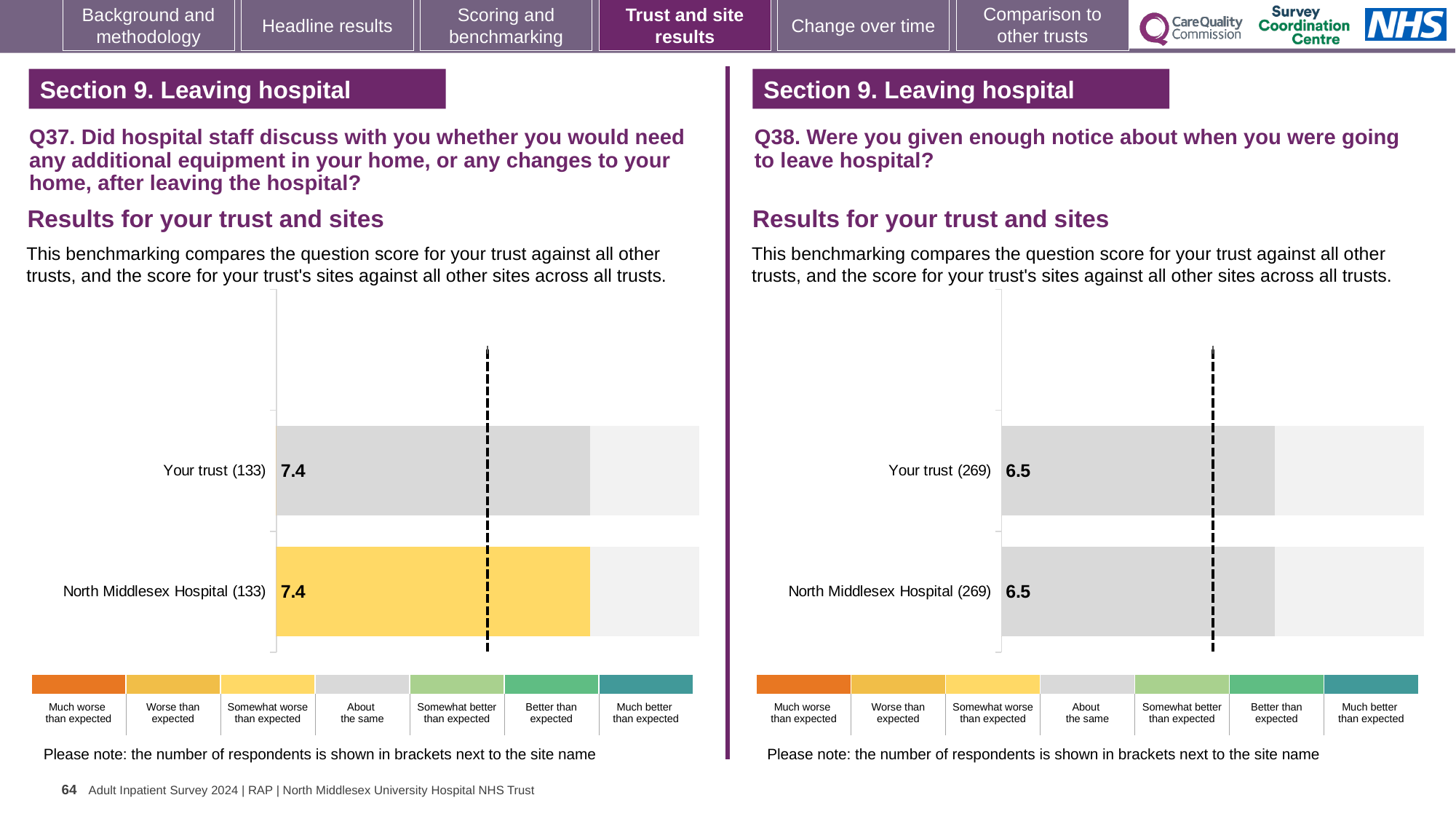
In the Q38 chart on the right, what is the score for Your trust? 6.5 How many bars are plotted in the Q37 chart on the left? 2 How many bars are plotted in the Q38 chart on the right? 2 In the Q37 chart on the left, how many respondents are shown in brackets next to North Middlesex Hospital? 133 In the Q37 chart on the left, what is the score for North Middlesex Hospital? 7.4 In the Q38 chart on the right, what is the difference between the score for Your trust and the score for North Middlesex Hospital? 0.0 In the Q38 chart on the right, how many respondents are shown in brackets next to Your trust? 269 In the Q37 chart on the left, what is the score for Your trust? 7.4 In the Q37 chart on the left, which benchmark category does the colour of the North Middlesex Hospital bar correspond to? Somewhat worse than expected In the Q38 chart on the right, what is the score for North Middlesex Hospital? 6.5 What kind of chart is used for the Q37 results on the left? Bar chart In the Q37 chart on the left, what is the difference between the score for Your trust and the score for North Middlesex Hospital? 0.0